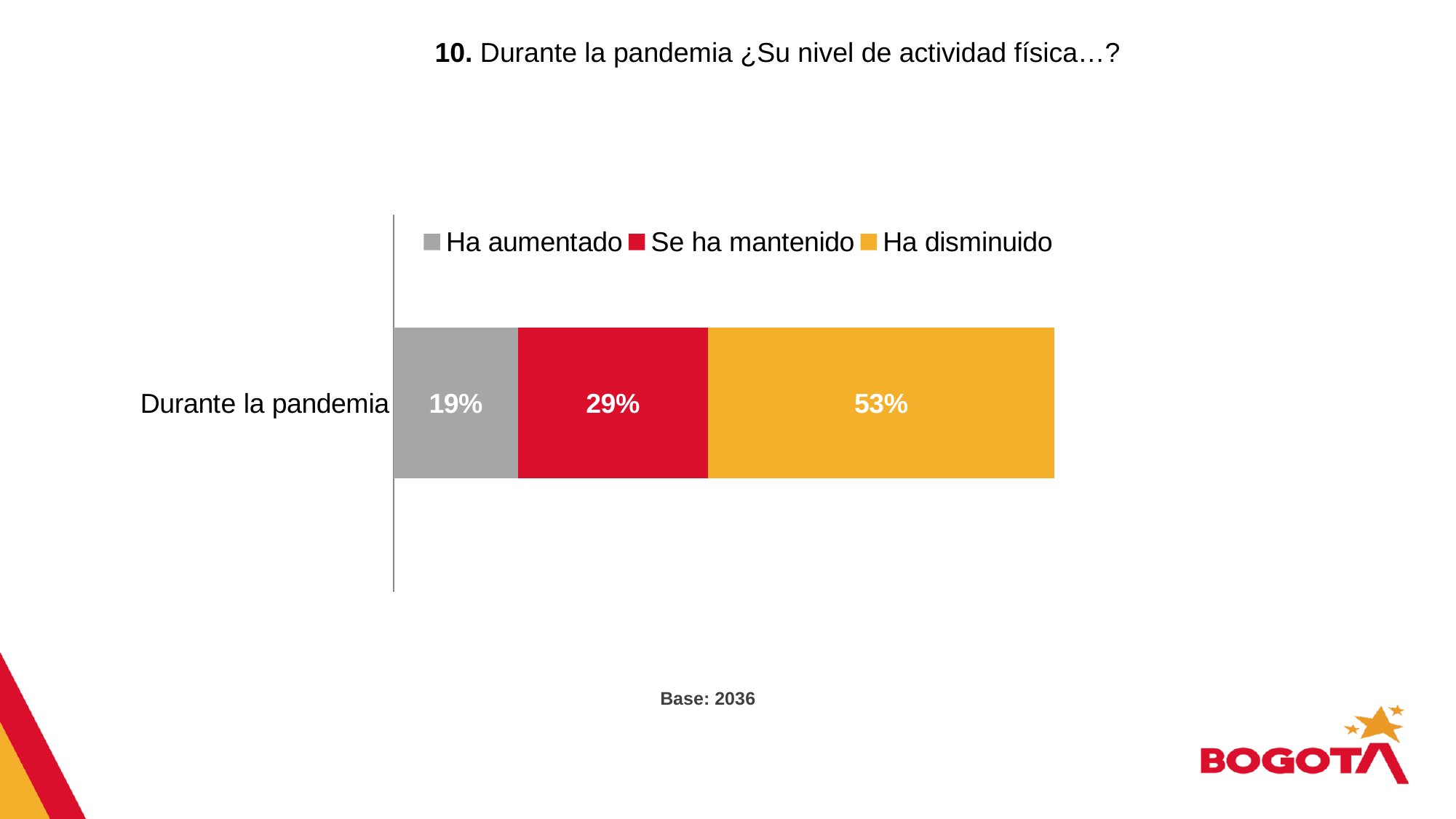
What colour is the "Ha disminuido" segment of the bar? Yellow/orange What percentage is shown for "Ha disminuido" in the "Durante la pandemia" bar? 53% What percentage is shown for "Ha aumentado" in the "Durante la pandemia" bar? 19% Which response has the smallest share of the "Durante la pandemia" bar? Ha aumentado What is the difference in percentage points between "Se ha mantenido" and "Ha aumentado"? 10 Which is larger, the share for "Ha aumentado" or the share for "Se ha mantenido"? Se ha mantenido What kind of chart is shown on the slide? Stacked bar chart What is the difference in percentage points between "Ha disminuido" and "Se ha mantenido"? 24 What percentage is shown for "Se ha mantenido" in the "Durante la pandemia" bar? 29% What is the total of the three segments in the "Durante la pandemia" bar? 101% Which response has the largest share of the "Durante la pandemia" bar? Ha disminuido How many series does the legend list? 3